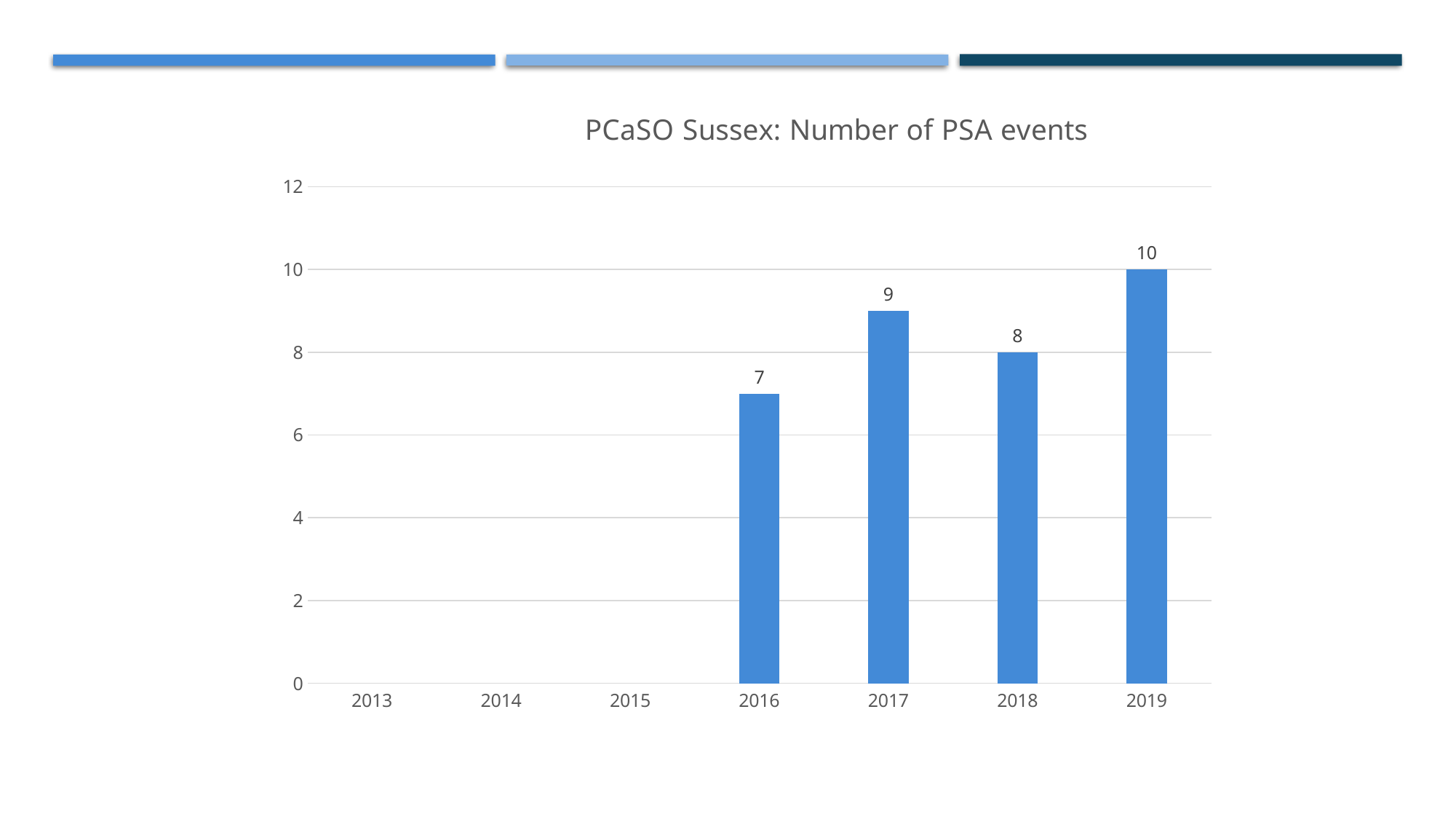
What is the number of PSA events in 2017? 9 How many years are labelled on the x axis? 7 What is the difference in the number of PSA events between 2019 and 2016? 3 Among the years with a bar shown, which year has the lowest number of PSA events? 2016 Is the value for 2017 greater or less than 8? greater What is the title of the chart? PCaSO Sussex: Number of PSA events Which year has the highest number of PSA events? 2019 What is the number of PSA events in 2016? 7 What kind of chart is shown on the slide? Bar chart Which year had more PSA events, 2017 or 2018? 2017 What is the number of PSA events in 2018? 8 What is the number of PSA events in 2019? 10